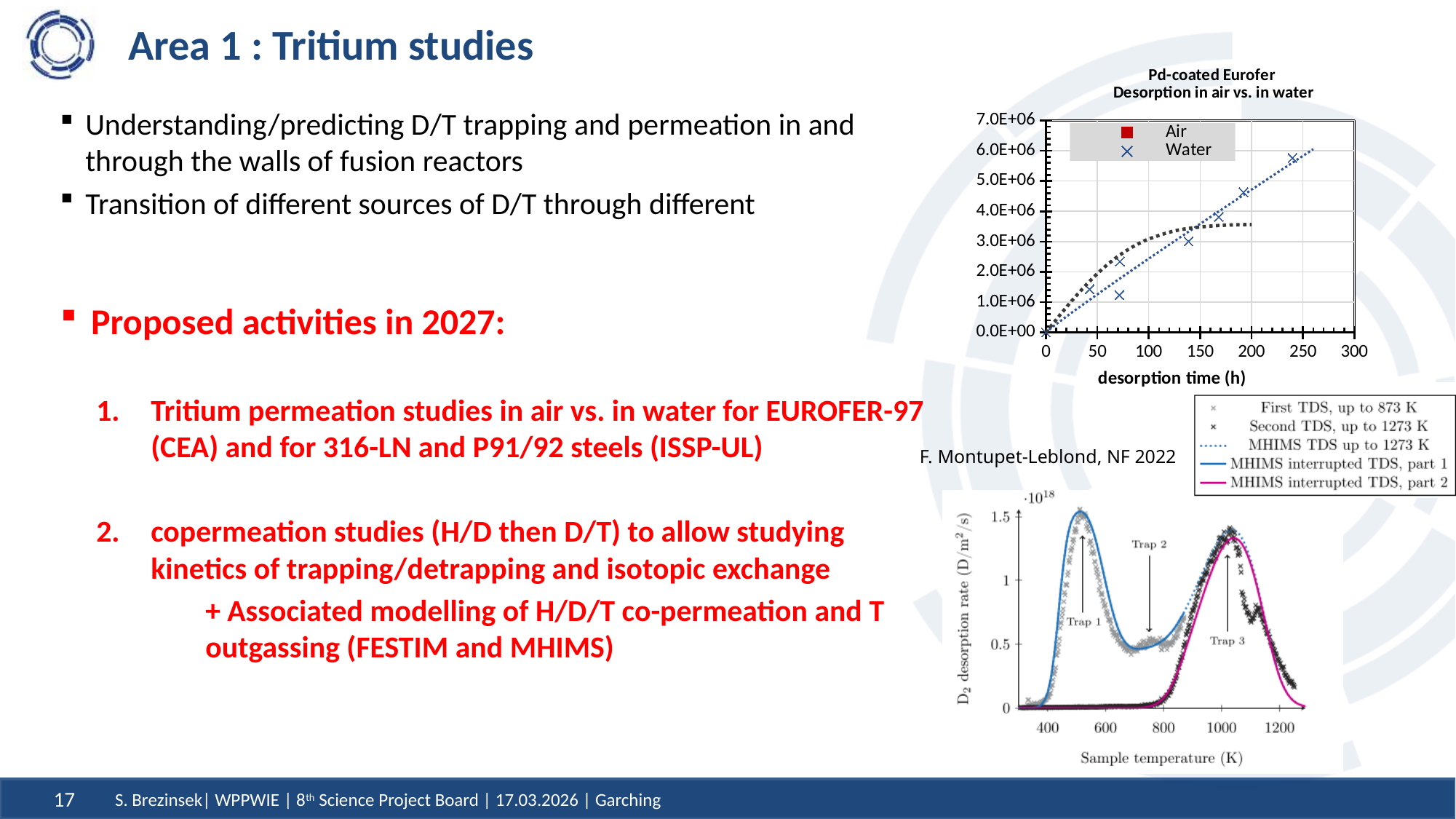
In the bottom-right TDS chart, how many entries does the legend list? 5 In the 'Pd-coated Eurofer' chart, what is the highest value shown on the y axis? 7.0E+06 In the 'Pd-coated Eurofer' chart, do the Water values rise or fall as desorption time increases? rise In the 'Pd-coated Eurofer' chart, what kind of chart is shown? scatter chart In the 'Pd-coated Eurofer' chart, is the Water value at about 190 h greater or less than 4.0E+06? greater In the bottom-right TDS chart, how many traps are labelled on the plot? 3 In the 'Pd-coated Eurofer' chart, how many series does the legend list? 2 In the 'Pd-coated Eurofer' chart, is the Water value at about 240 h greater or less than 5.0E+06? greater In the bottom-right TDS chart, is the Trap 1 peak greater or less than 1 (×10^18)? greater In the bottom-right TDS chart, which peak is higher, Trap 1 or Trap 3? Trap 1 What is the title of the chart in the top right of the slide? Pd-coated Eurofer Desorption in air vs. in water